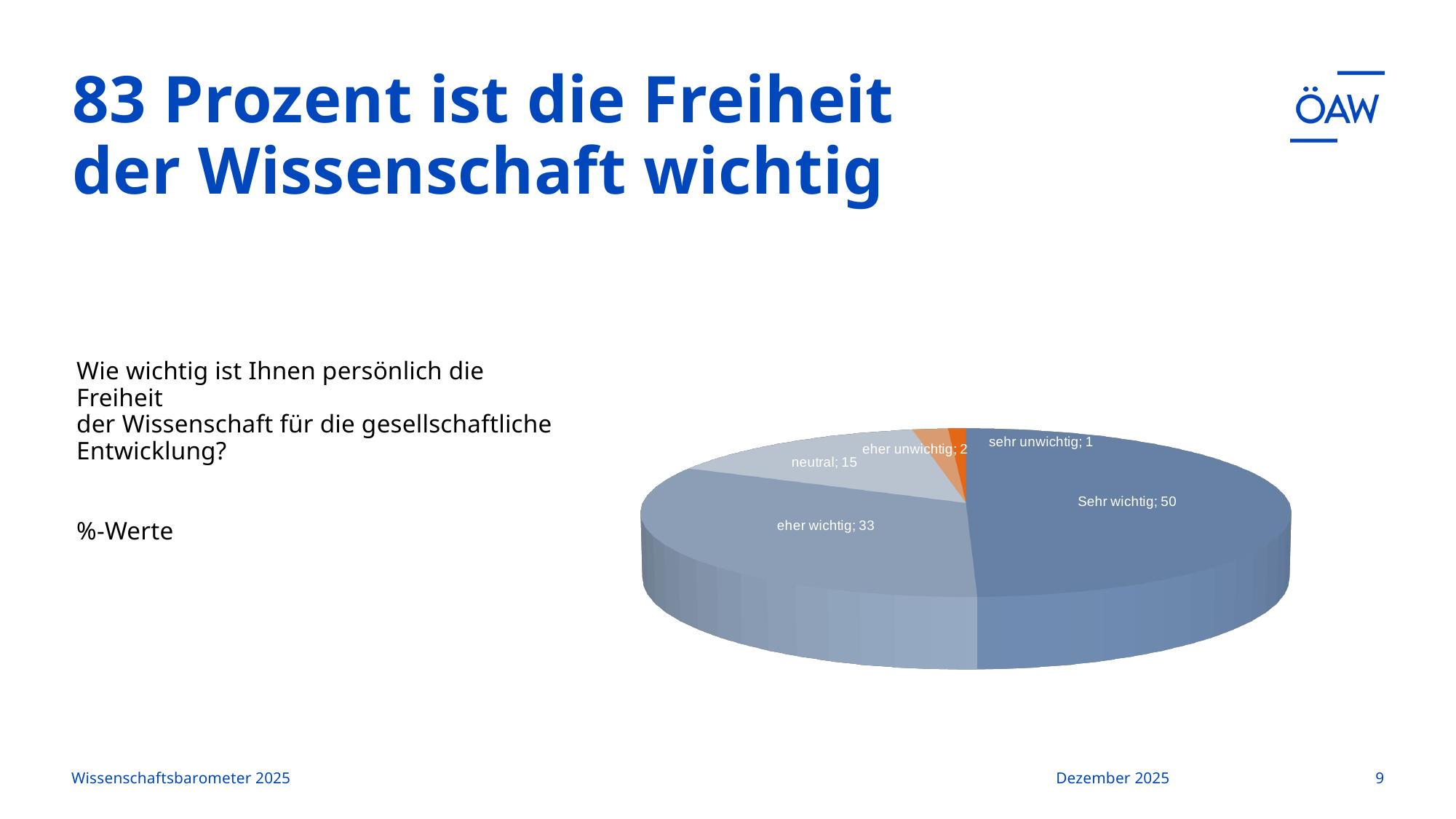
What is the difference between the values for "Sehr wichtig" and "eher wichtig"? 17 What kind of chart is shown on the slide? pie chart What is the combined value of "Sehr wichtig" and "eher wichtig"? 83 How many slices does the pie chart have? 5 Which category has the largest slice? Sehr wichtig Which is larger, the value for "neutral" or the value for "eher unwichtig"? neutral What value is shown for "neutral"? 15 What value is shown for "sehr unwichtig"? 1 Which category has the smallest slice? sehr unwichtig What value is shown for "eher wichtig"? 33 What value is shown for "Sehr wichtig"? 50 What value is shown for "eher unwichtig"? 2